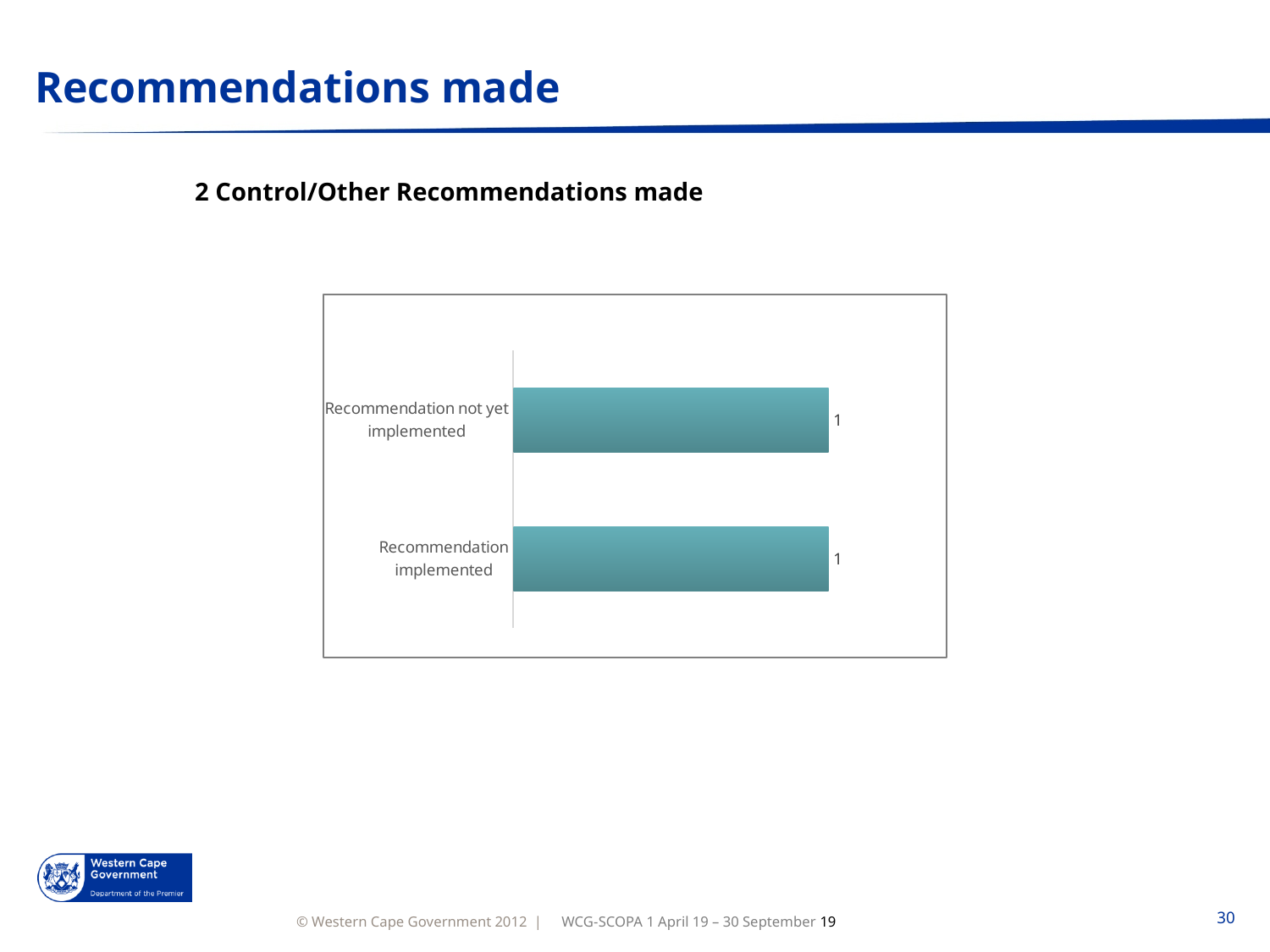
How many categories are shown in the chart? 2 What is the difference between the values for "Recommendation not yet implemented" and "Recommendation implemented"? 0 What is the heading printed above the chart? 2 Control/Other Recommendations made What kind of chart is shown on the slide? Bar chart What is the value for "Recommendation implemented"? 1 What is the value for "Recommendation not yet implemented"? 1 Are the bars in the chart horizontal or vertical? Horizontal What is the total of the two values plotted in the chart? 2